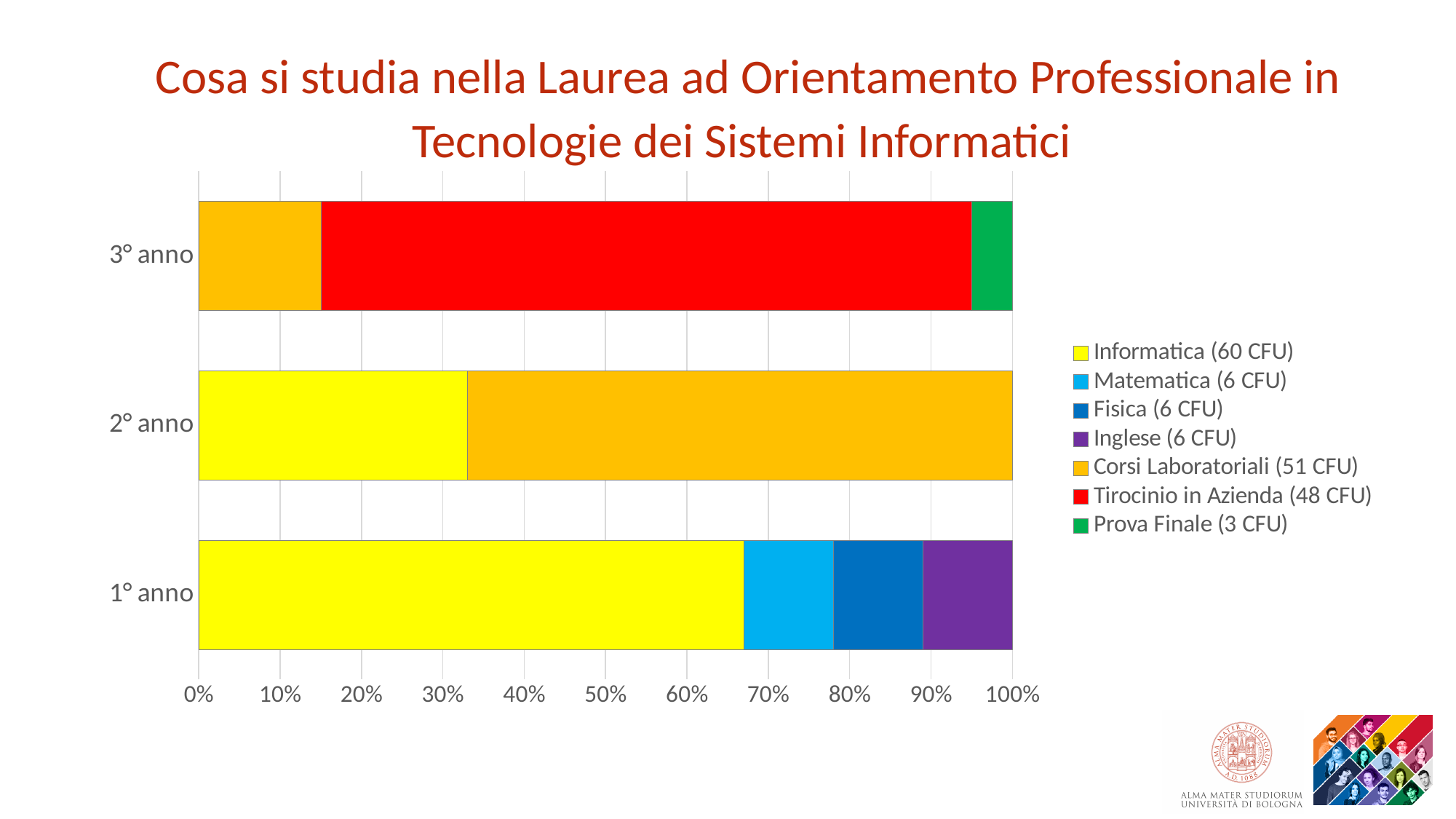
Is the Informatica share of the 2° anno bar greater or less than 40%? less Is the Corsi Laboratoriali share of the 3° anno bar greater or less than 20%? less Which year has the largest Informatica share? 1° anno In the 2° anno bar, which is larger: the Informatica segment or the Corsi Laboratoriali segment? Corsi Laboratoriali According to the legend, how many CFU does Tirocinio in Azienda account for? 48 CFU What kind of chart is shown on the slide? Stacked bar chart Which series takes up the largest share of the 3° anno bar? Tirocinio in Azienda How many year categories (anni) are plotted on the chart? 3 Which legend entry is shown in green? Prova Finale (3 CFU) How many series does the legend list? 7 Is the Tirocinio in Azienda share of the 3° anno bar greater or less than 70%? greater